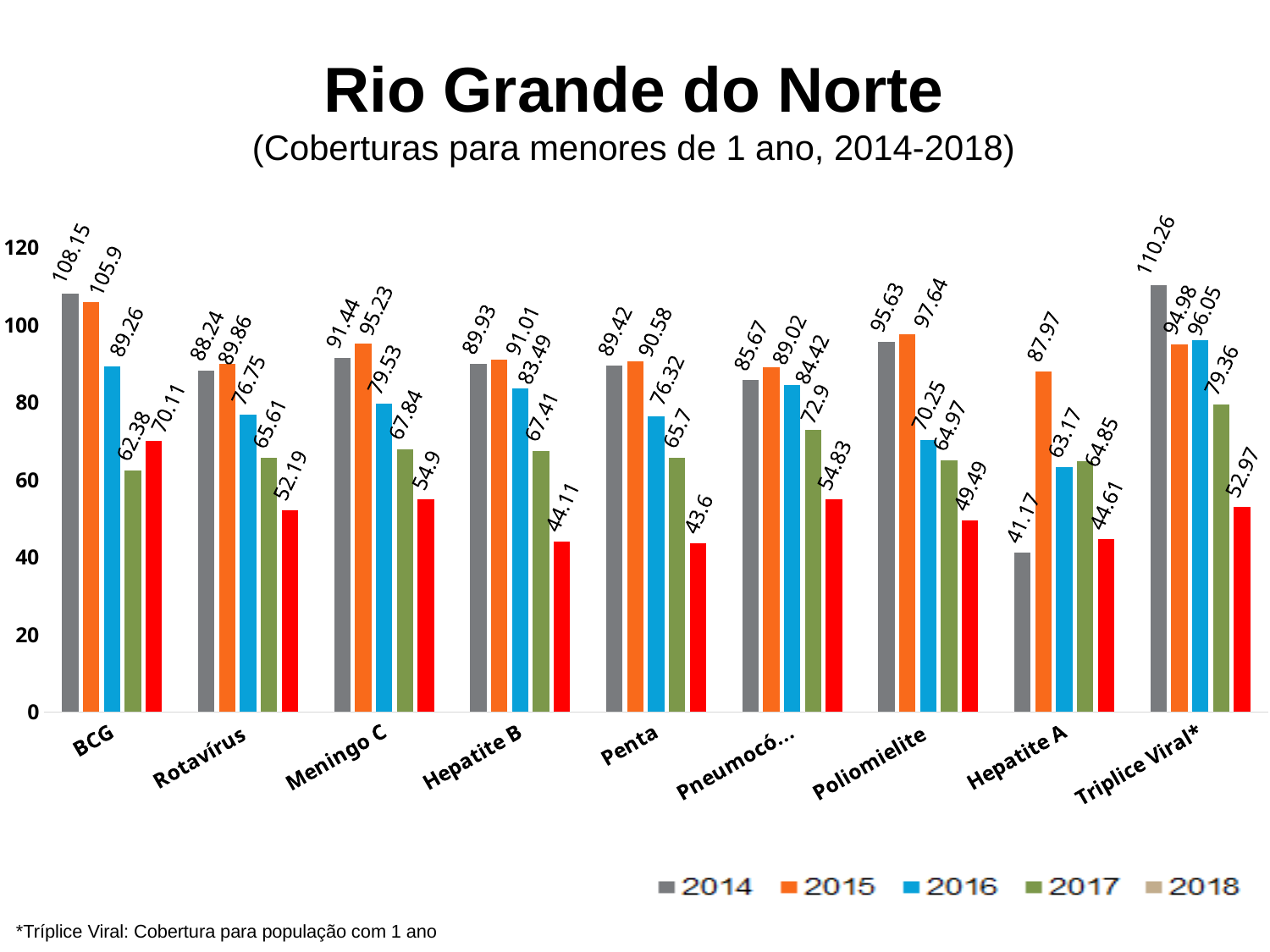
How many series does the legend list? 5 What kind of chart is shown on the slide? bar chart How many vaccine categories are shown on the x axis? 9 Which is larger, the 2015 value for Poliomielite or the 2015 value for Meningo C? Poliomielite Which vaccine has the lowest 2018 value? Penta What is the difference between the 2014 and 2018 values for BCG? 38.04 Which vaccine has the highest 2014 value? Tríplice Viral* What is the 2017 value for Pneumocó...? 72.9 Which vaccine has the lowest 2014 value? Hepatite A From 2015 to 2018, do the values for Penta rise or fall? fall What is the value for Hepatite A in 2015? 87.97 What is the value for BCG in 2014? 108.15